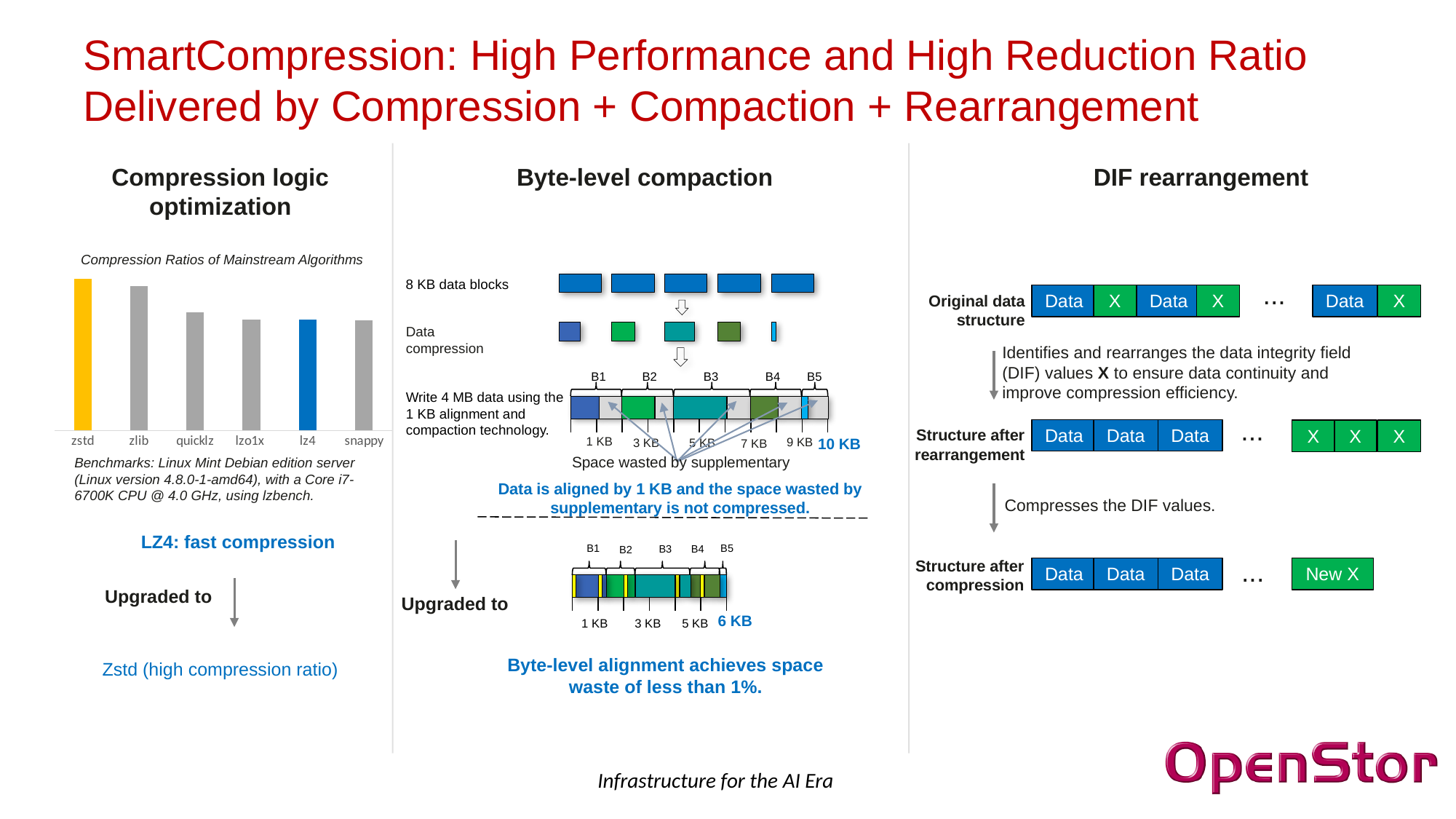
How many algorithms are shown in the "Compression Ratios of Mainstream Algorithms" chart? 6 In the "Compression Ratios of Mainstream Algorithms" chart, which has the larger compression ratio, quicklz or lz4? quicklz In the "Compression Ratios of Mainstream Algorithms" chart, which has the larger compression ratio, zstd or snappy? zstd What kind of chart is the "Compression Ratios of Mainstream Algorithms" chart? bar chart Do the bars in the "Compression Ratios of Mainstream Algorithms" chart generally rise or fall from left to right? fall What is the last category on the x axis of the "Compression Ratios of Mainstream Algorithms" chart? snappy Which algorithm's bar is coloured blue in the "Compression Ratios of Mainstream Algorithms" chart? lz4 In the "Compression Ratios of Mainstream Algorithms" chart, which has the larger compression ratio, zlib or lz4? zlib Which algorithm's bar is coloured yellow in the "Compression Ratios of Mainstream Algorithms" chart? zstd What is the first category on the x axis of the "Compression Ratios of Mainstream Algorithms" chart? zstd Which algorithm has the highest compression ratio in the "Compression Ratios of Mainstream Algorithms" chart? zstd